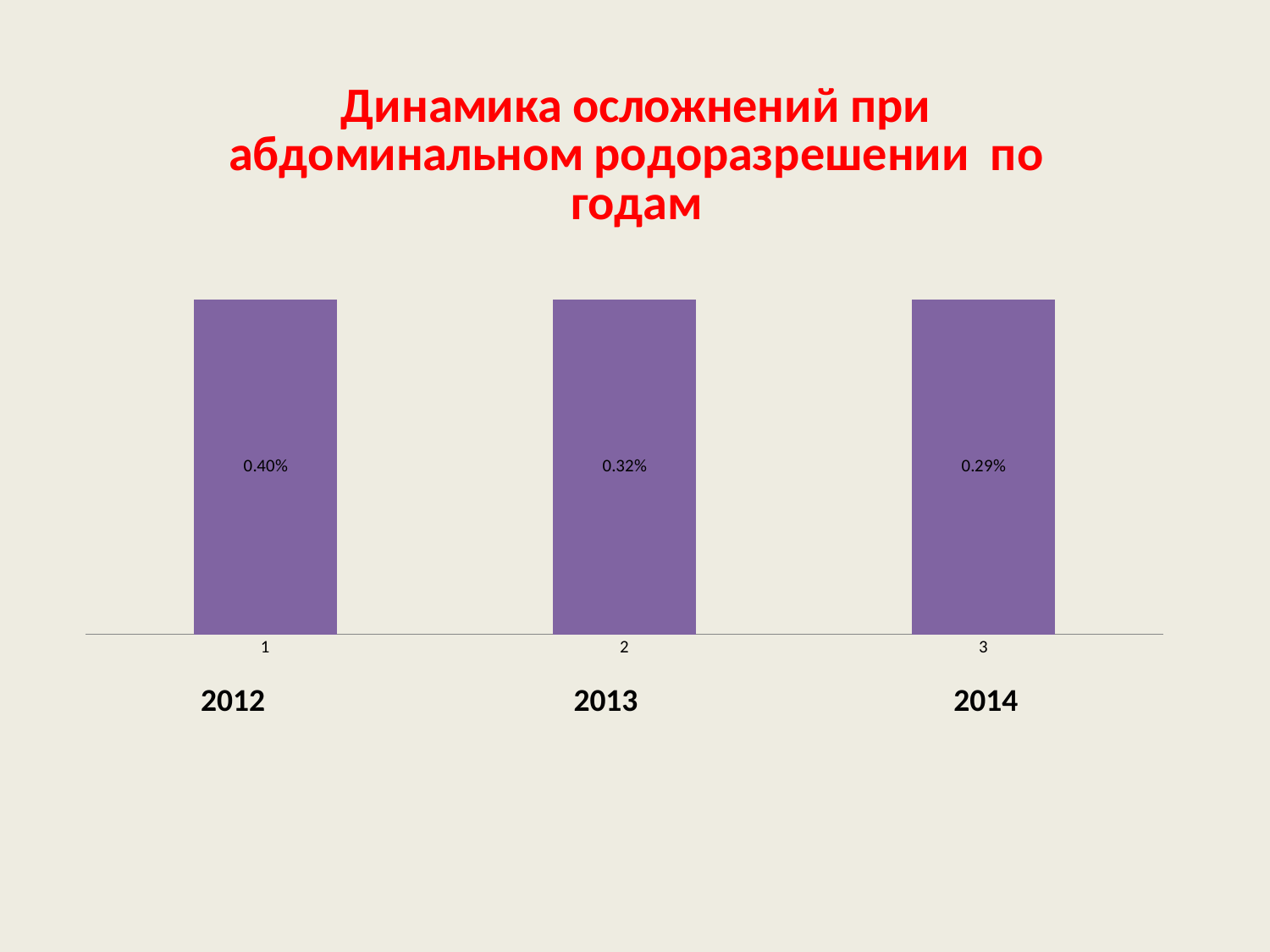
What is the value shown for 2013? 0.32% What is the value shown for 2014? 0.29% According to the data labels, which year has the lowest value? 2014 Based on the data labels, which is larger: the value for 2013 or the value for 2014? 2013 How many bars are plotted in the chart? 3 What is the difference between the values for 2013 and 2014? 0.03% What is the difference between the values for 2012 and 2014? 0.11% What is the value shown for 2012? 0.40% According to the data labels, do the values rise or fall from 2012 to 2014? Fall What kind of chart is shown on the slide? Bar chart According to the data labels, which year has the highest value? 2012 What is the difference between the values for 2012 and 2013? 0.08%